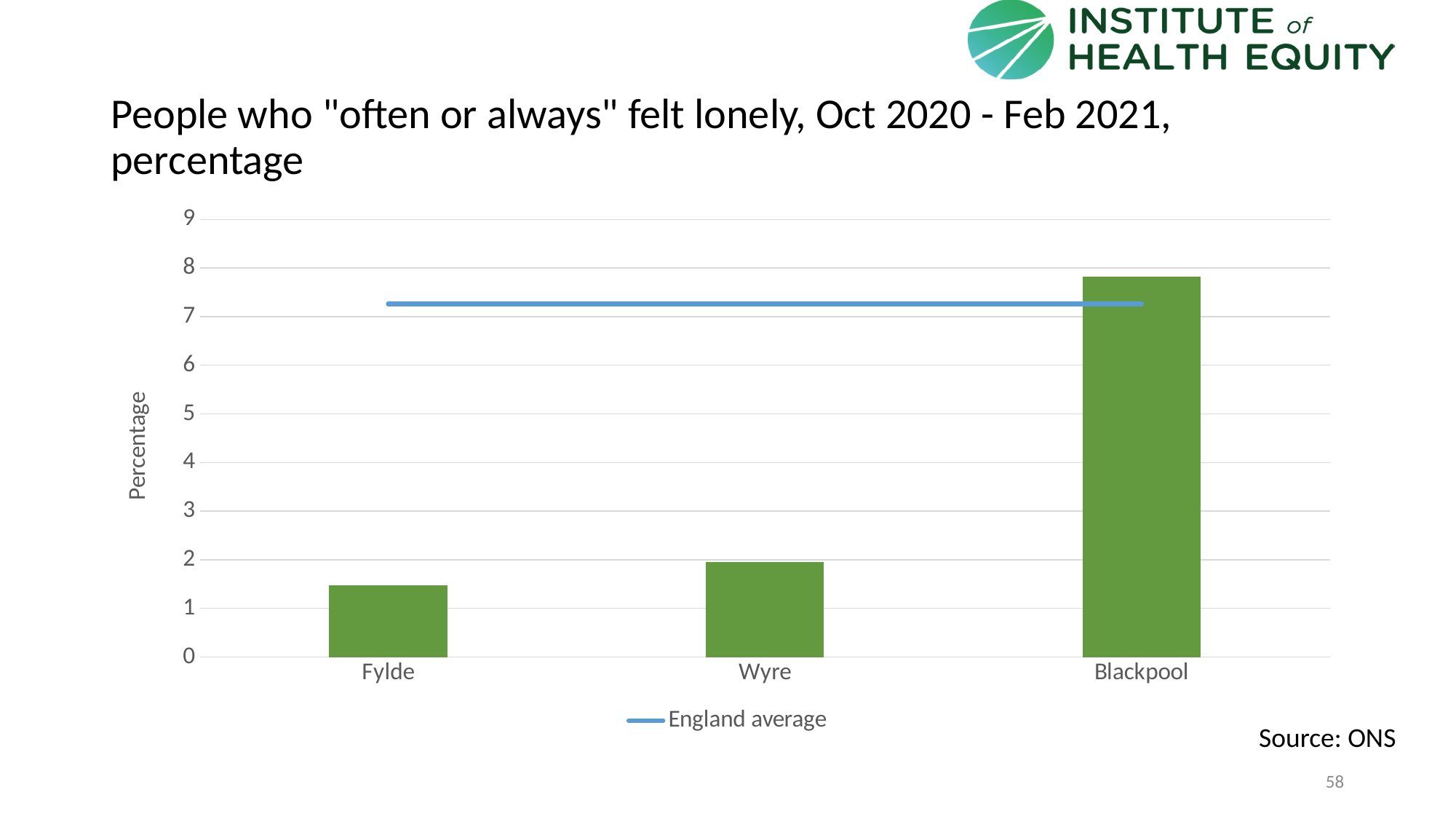
Is the England average line greater or less than 7? greater What is the label on the vertical axis of the chart? Percentage Is the value for Blackpool greater or less than 7? greater Is the value for Wyre greater or less than 3? less Which area has the highest percentage of people who often or always felt lonely? Blackpool What does the blue horizontal line on the chart represent, according to the legend? England average Do the bar values rise or fall moving from Fylde to Blackpool along the x axis? Rise Which has the larger value, Wyre or Fylde? Wyre What kind of chart is shown on the slide? Bar chart Which area has the lowest percentage of people who often or always felt lonely? Fylde How many areas are shown as bars on the chart? 3